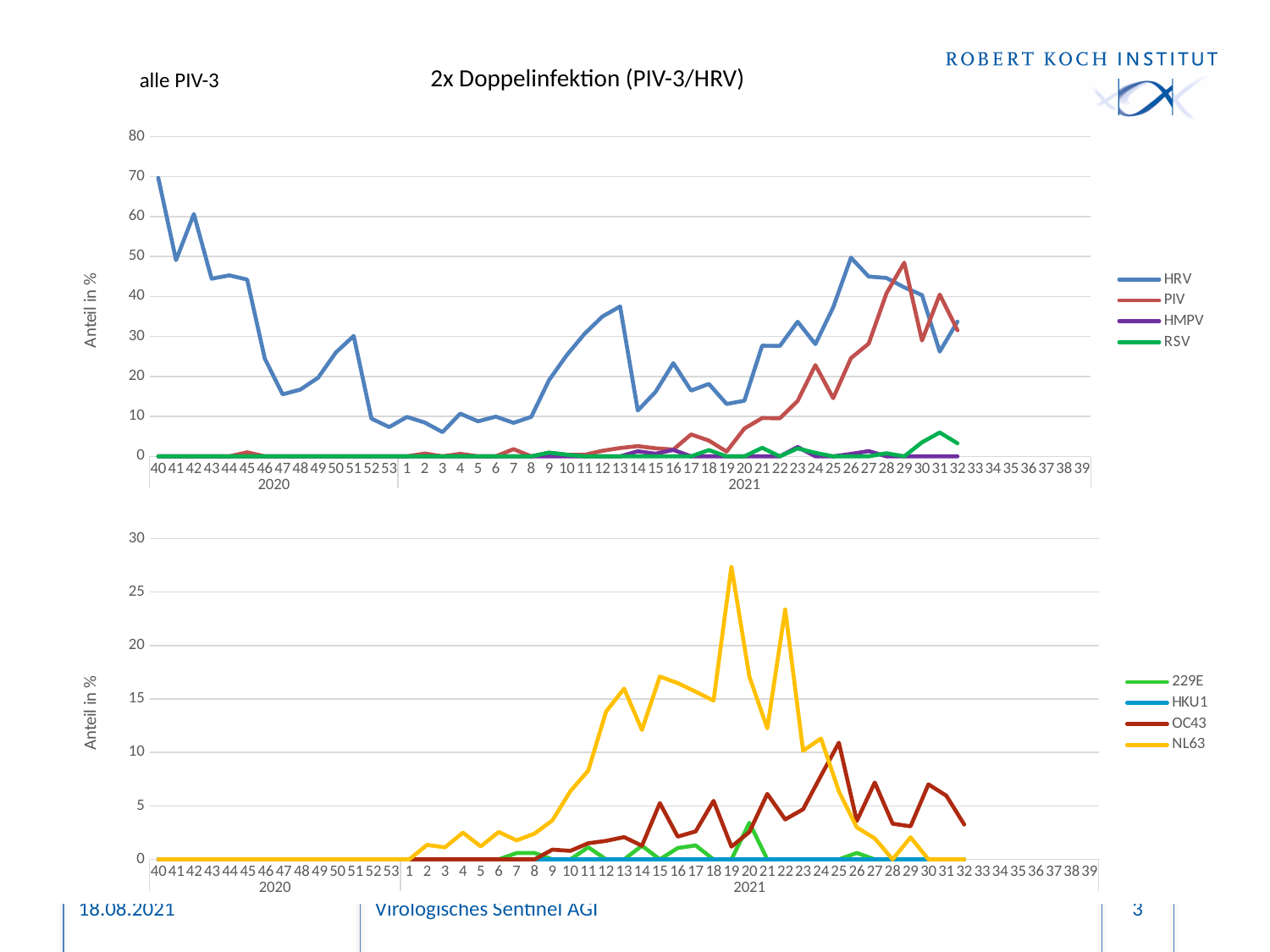
In the top chart, is the value for HRV at week 40 of 2020 greater or less than 60? greater In the top chart, is the value for PIV at week 29 of 2021 greater or less than 40? greater In the top chart, does the HRV line rise or fall from week 40 to week 47 of 2020? fall What is the y-axis label of the top chart? Anteil in % In the bottom chart, is the value for OC43 at week 25 of 2021 greater or less than 10? greater What type of chart is the top chart on the slide? line chart In the bottom chart, which is larger at week 19 of 2021, NL63 or OC43? NL63 How many series does the legend of the top chart list? 4 In the bottom chart, which series reaches the highest value? NL63 How many series does the legend of the bottom chart list? 4